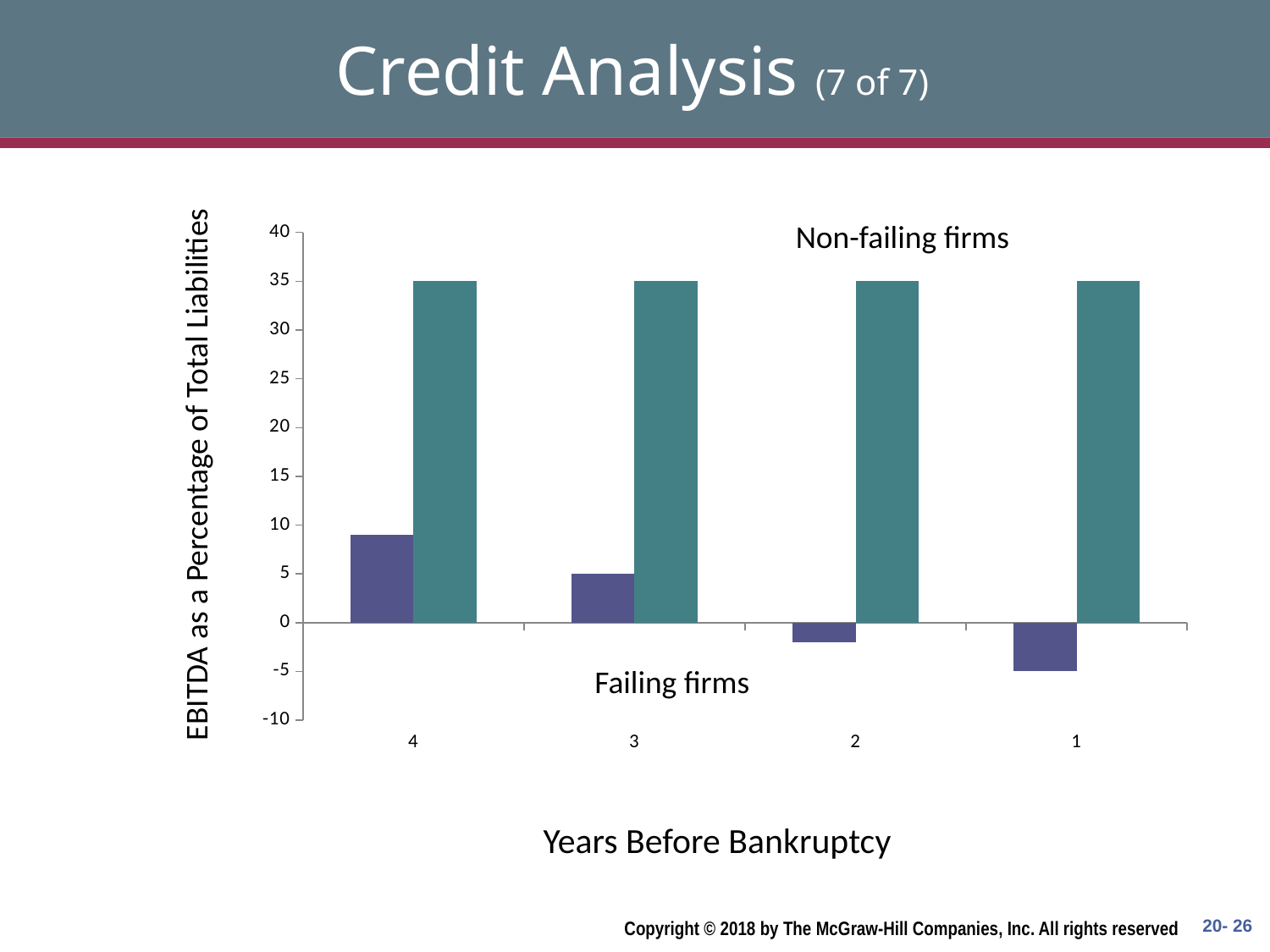
What is the label on the y axis? EBITDA as a Percentage of Total Liabilities What kind of chart is shown on the slide? Bar chart How many series are plotted in the chart? 2 Is the value for Failing firms at 2 years before bankruptcy greater or less than 0? less What is the value for Failing firms at 1 year before bankruptcy? -5 What is the difference between Non-failing firms and Failing firms at 3 years before bankruptcy? 30 What is the value for Failing firms at 3 years before bankruptcy? 5 How many categories (years before bankruptcy) are shown on the x axis? 4 At 1 year before bankruptcy, which series has the larger value, Failing firms or Non-failing firms? Non-failing firms Do the values for Failing firms rise or fall moving from 4 years to 1 year before bankruptcy? Fall What is the value for Non-failing firms at 4 years before bankruptcy? 35 Is the value for Failing firms at 4 years before bankruptcy greater or less than 5? greater